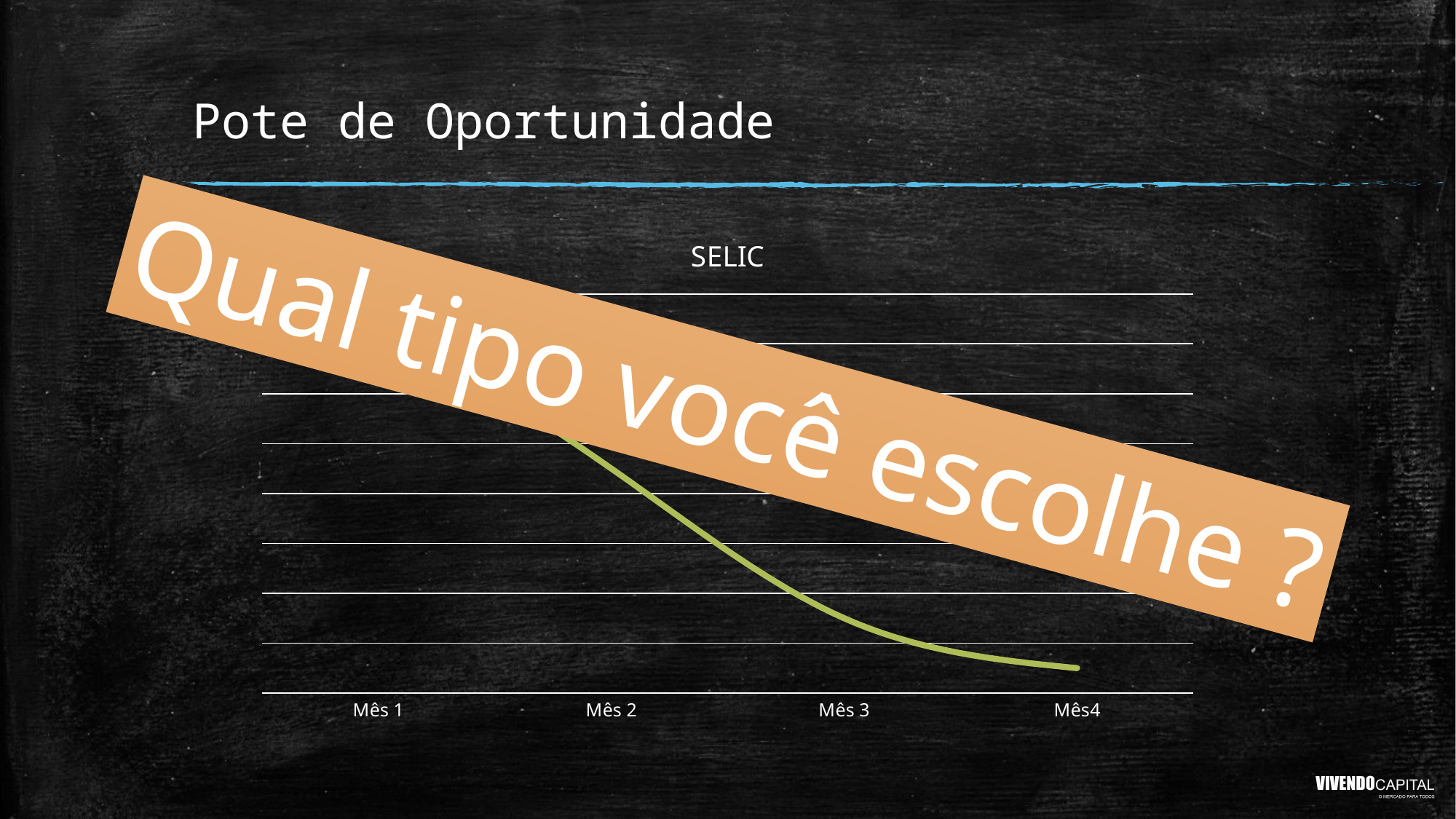
Which month has the lowest value in the SELIC chart? Mês4 What kind of chart is shown on the slide? line chart How many categories are shown on the x axis of the SELIC chart? 4 What is the label of the last category on the x axis of the SELIC chart? Mês4 Do the values in the SELIC chart rise or fall from Mês 2 to Mês4? fall In the SELIC chart, which is larger, the value for Mês 3 or the value for Mês4? Mês 3 What is the title of the chart? SELIC In the SELIC chart, which is larger, the value for Mês 2 or the value for Mês4? Mês 2